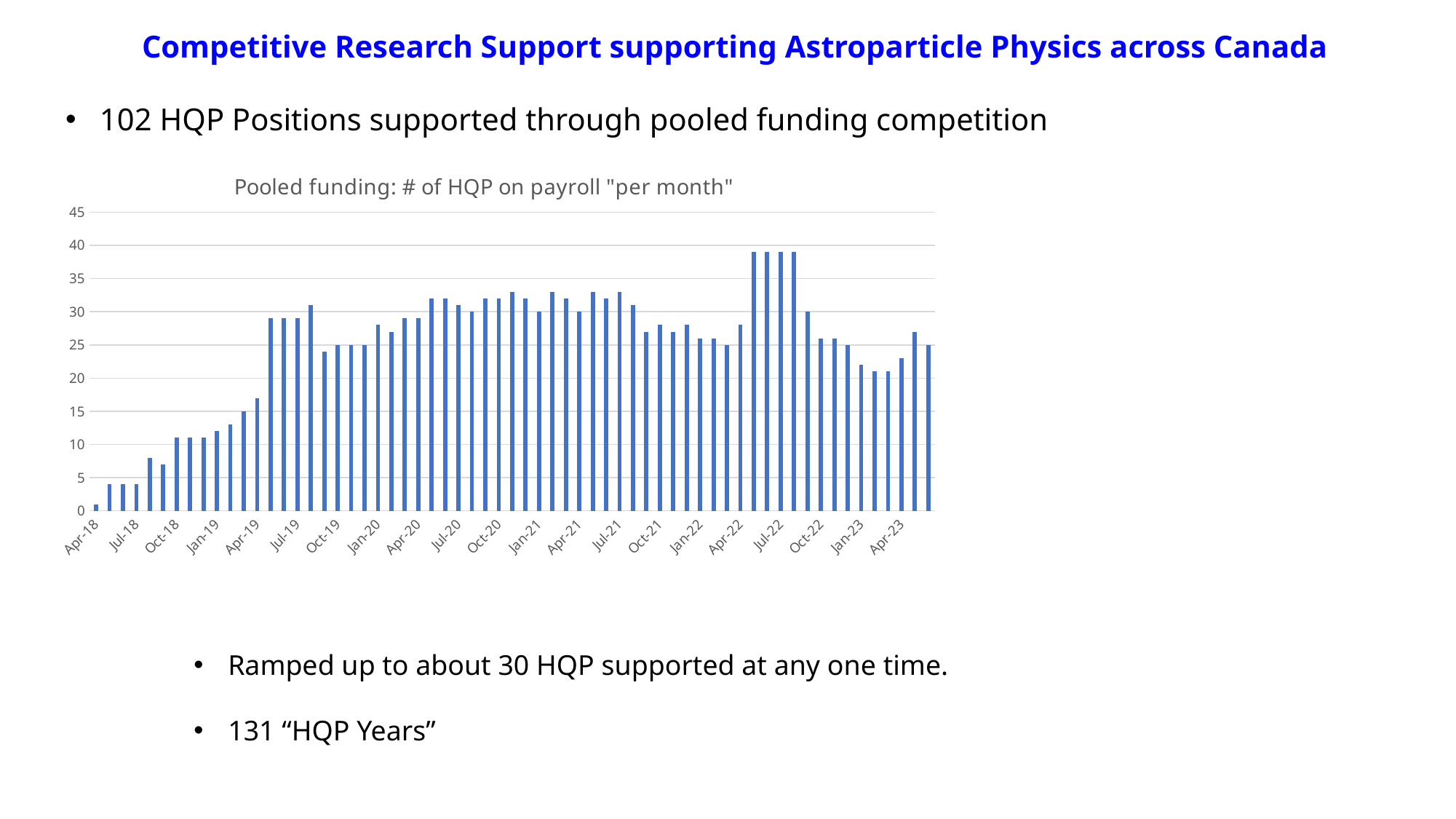
Is the value for Jan-23 greater or less than 25? less What is the highest tick value shown on the vertical axis? 45 Is the value for Apr-18 greater or less than 5? less Which is larger, the value for Jul-22 or the value for Jan-23? Jul-22 Is the value for Jul-22 greater or less than 35? greater What kind of chart is shown on the slide? bar chart Which month has the lowest value in the chart? Apr-18 Do the values rise or fall from Apr-18 to Jul-19? rise What is the title of the chart? Pooled funding: # of HQP on payroll "per month"